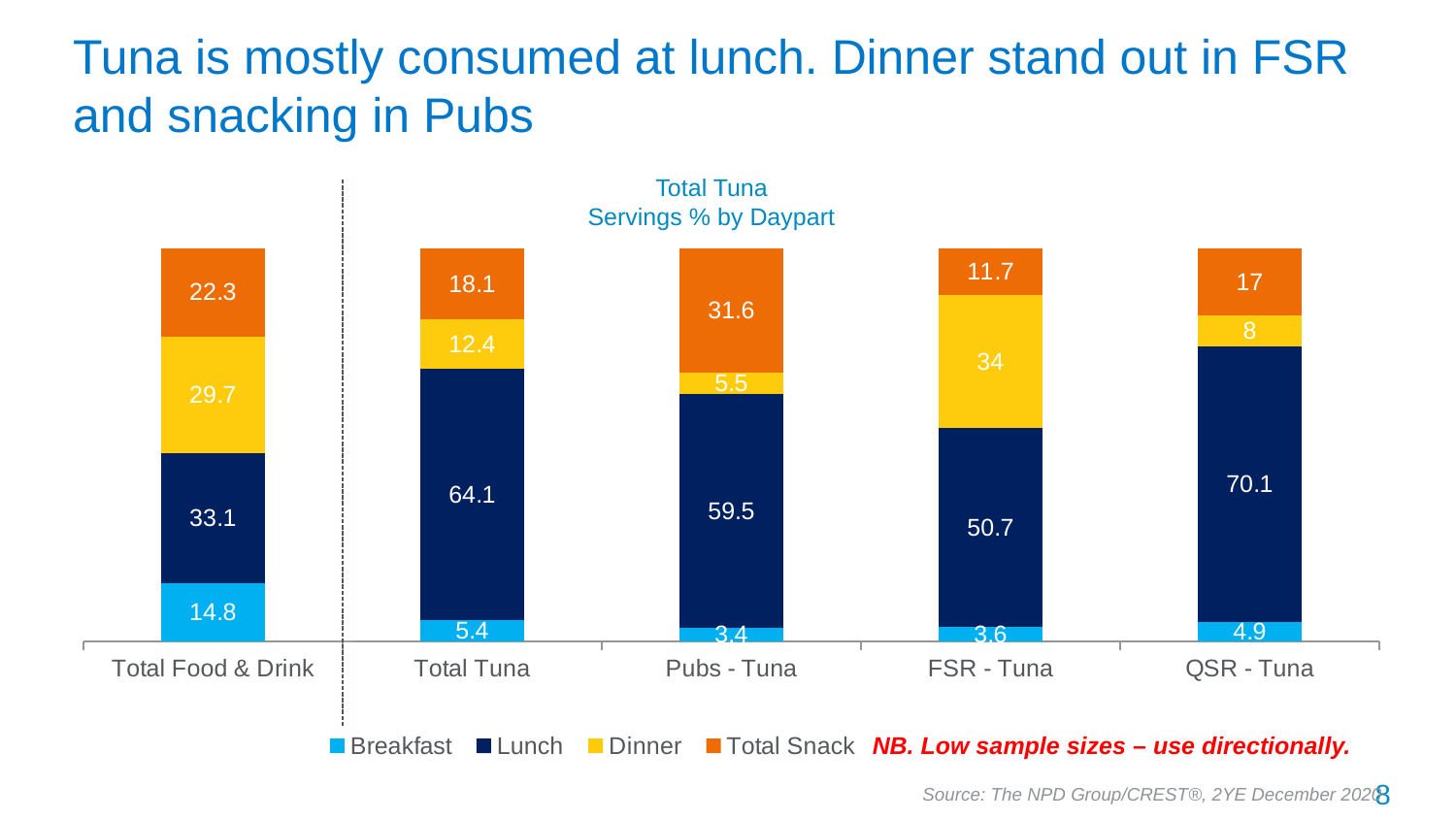
How many categories are shown on the x axis? 5 What kind of chart is shown on the slide? Stacked bar chart Which category has the lowest Breakfast value? Pubs - Tuna What is the Breakfast value for Total Food & Drink? 14.8 What is the Dinner value for FSR - Tuna? 34 What is the Total Snack value for Pubs - Tuna? 31.6 What is the total of the stacked bar for Total Tuna? 100 Which is larger: the Total Snack value for Total Tuna or the Total Snack value for QSR - Tuna? Total Tuna Which category has the highest Lunch value? QSR - Tuna How many series does the legend list? 4 What is the Lunch value for QSR - Tuna? 70.1 What is the difference between the Dinner value for FSR - Tuna and the Dinner value for Pubs - Tuna? 28.5